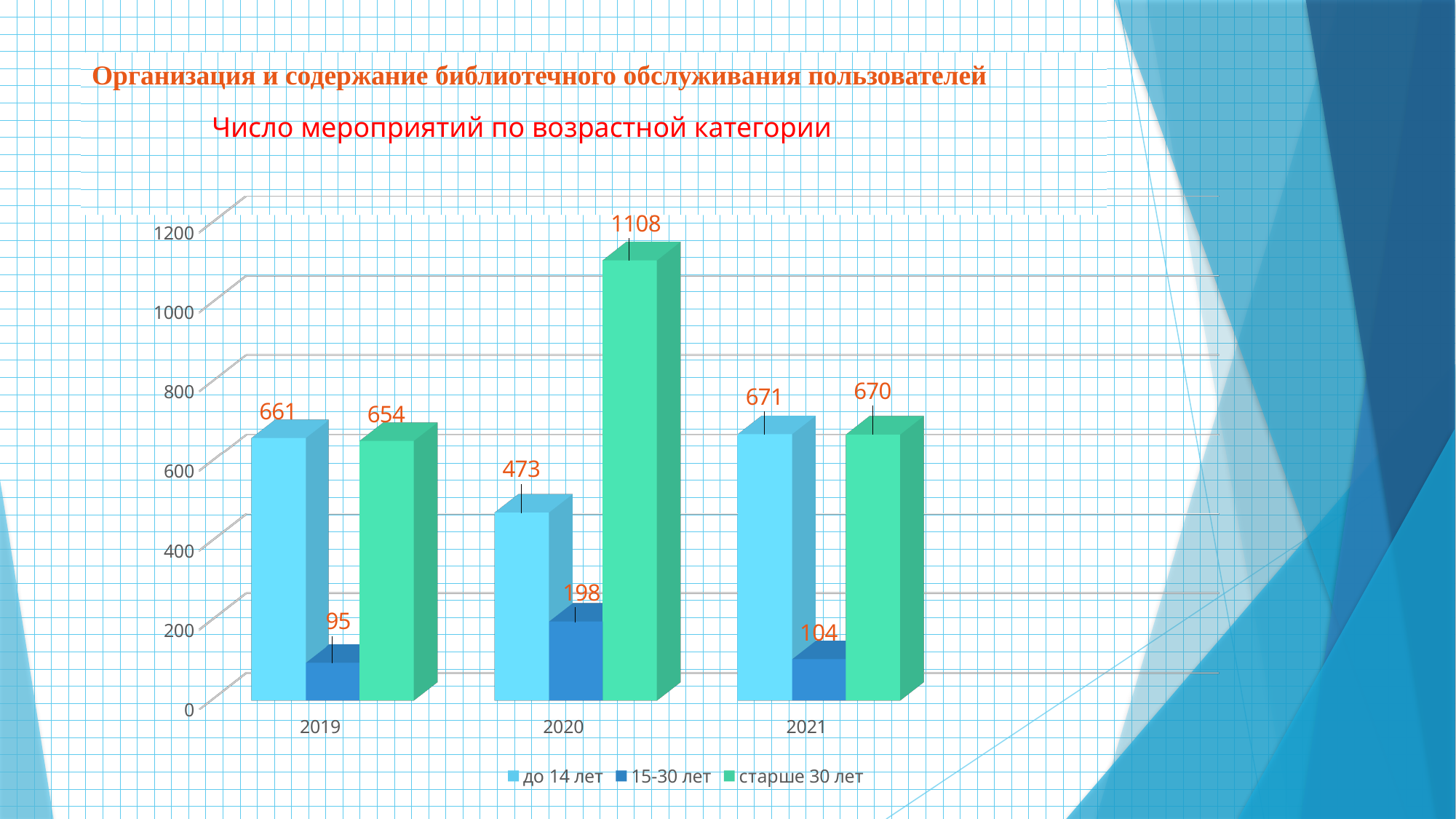
How many years are shown on the x axis? 3 What is the difference between the "старше 30 лет" value in 2020 and in 2021? 438 Which is larger in 2020: the value for "до 14 лет" or for "15-30 лет"? до 14 лет What is the value for "15-30 лет" in 2021? 104 Does the value for "15-30 лет" rise or fall from 2019 to 2020? rise What is the value for "до 14 лет" in 2019? 661 What is the value for "старше 30 лет" in 2020? 1108 In which year is the value for "15-30 лет" lowest? 2019 In which year is the value for "старше 30 лет" highest? 2020 How many series does the legend list? 3 What kind of chart is shown on the slide? bar chart What is the title of the chart? Число мероприятий по возрастной категории